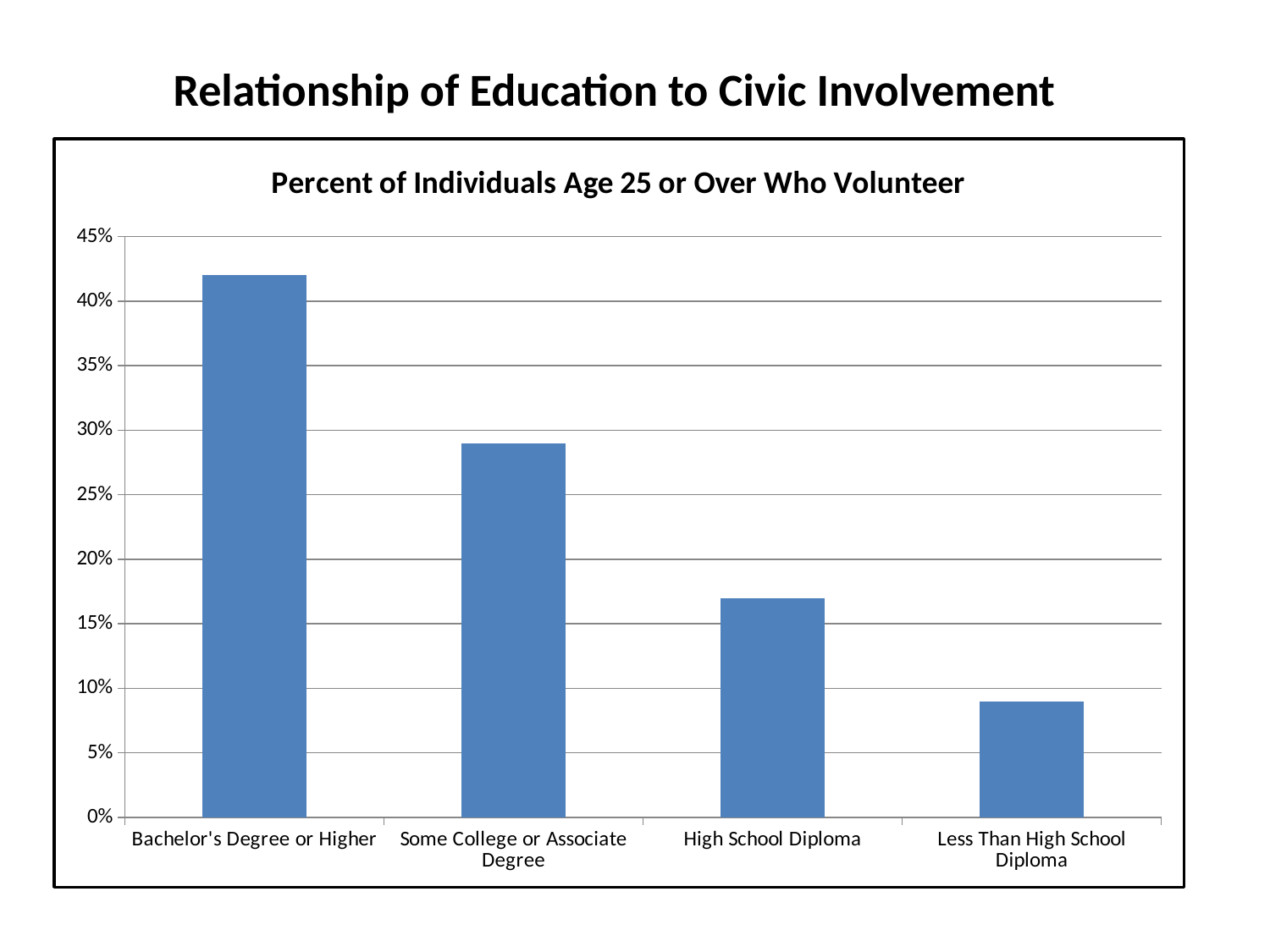
What type of chart is shown on the slide? bar chart Is the value for High School Diploma greater or less than 20%? less What is the title of the chart? Percent of Individuals Age 25 or Over Who Volunteer Do the values rise or fall moving from left to right across the categories? fall Is the value for Some College or Associate Degree greater or less than 25%? greater Is the value for Less Than High School Diploma greater or less than 5%? greater Which education category has the lowest percentage of individuals who volunteer? Less Than High School Diploma What is the highest value shown on the vertical axis? 45% How many education categories are shown on the chart? 4 Which is larger, the value for Some College or Associate Degree or the value for High School Diploma? Some College or Associate Degree Which education category has the highest percentage of individuals who volunteer? Bachelor's Degree or Higher